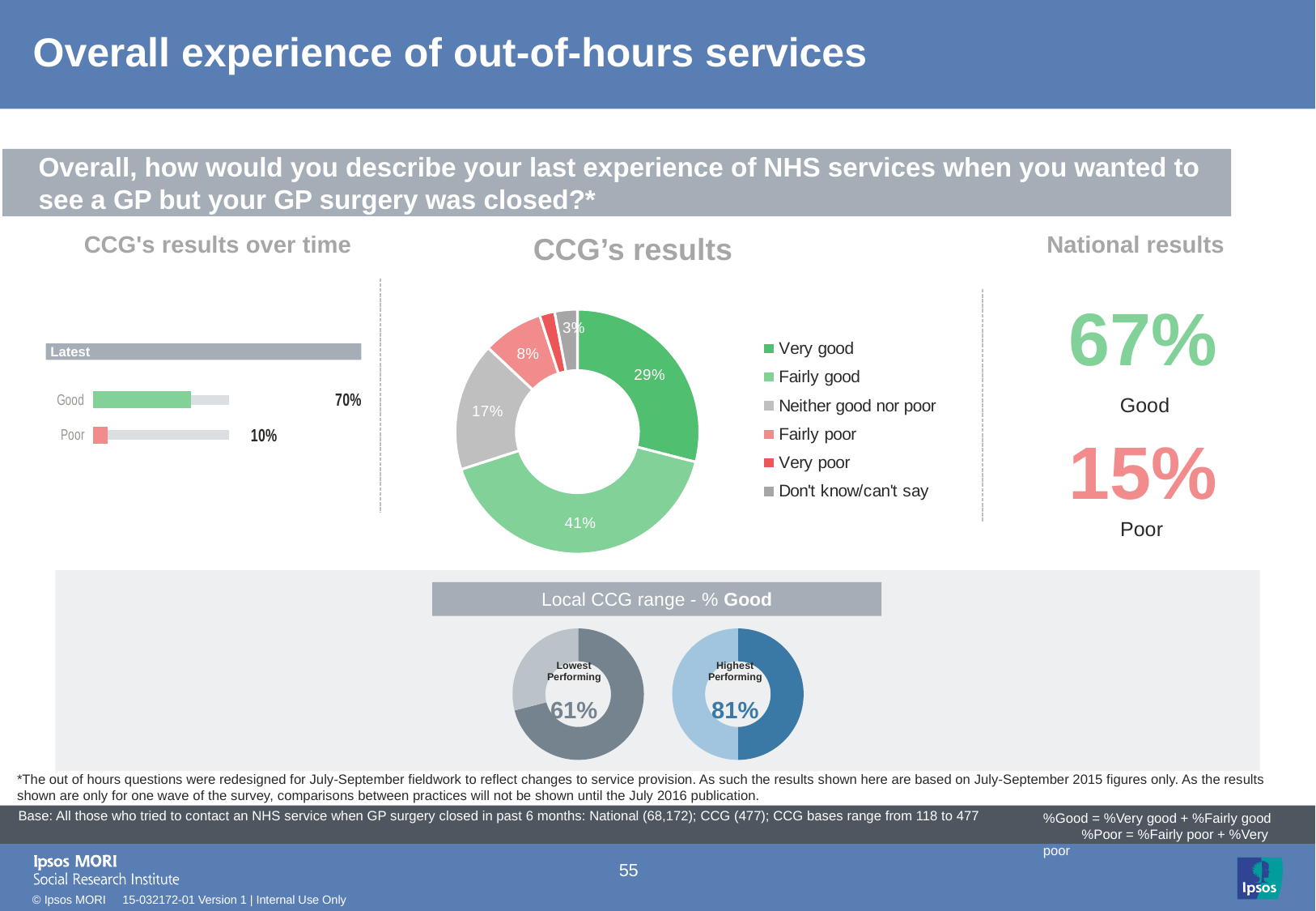
In the 'CCG's results over time' chart, what is the difference between the Good and Poor values? 60 percentage points In the 'Local CCG range - % Good' section, what is the value for the Lowest Performing CCG? 61% In the 'CCG's results' chart, what share is Fairly poor? 8% In the 'CCG's results over time' chart, what kind of chart is used? Bar chart In the 'CCG's results' chart, how many entries does the legend list? 6 In the 'CCG's results over time' chart, what is the value for Poor? 10% In the 'CCG's results' chart, what share is Very good? 29% In the 'CCG's results' chart, what share is Neither good nor poor? 17% In the 'CCG's results' chart, what share is Fairly good? 41% In the 'CCG's results over time' chart, what is the value for Good? 70% In the 'Local CCG range - % Good' section, what is the difference between the Highest Performing and Lowest Performing values? 20 percentage points In the 'CCG's results' chart, which category has the largest share? Fairly good